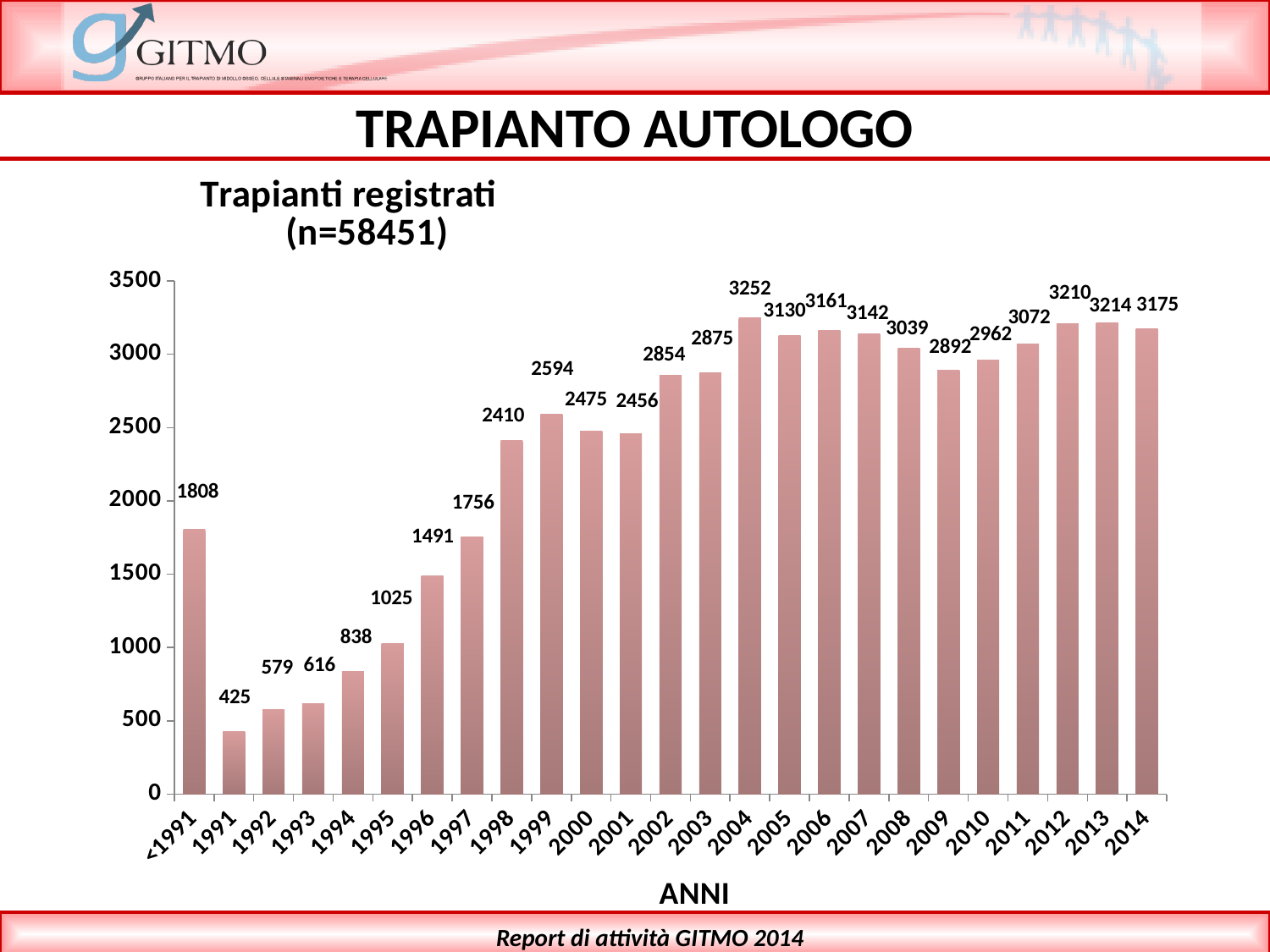
What is the value for 2009? 2892 What is the difference between the values for 2013 and 2014? 39 What is the difference between the values for 1998 and 1997? 654 Which year has the lowest value? 1991 Which is larger, the value for 1996 or the value for 1997? 1997 Which year has the highest value? 2004 How many categories are shown on the x axis? 25 What is the value for the <1991 category? 1808 Is the value for 2009 greater or less than 3000? less What is the title of the x axis? ANNI What kind of chart is shown on the slide? bar chart What is the value for 2004? 3252